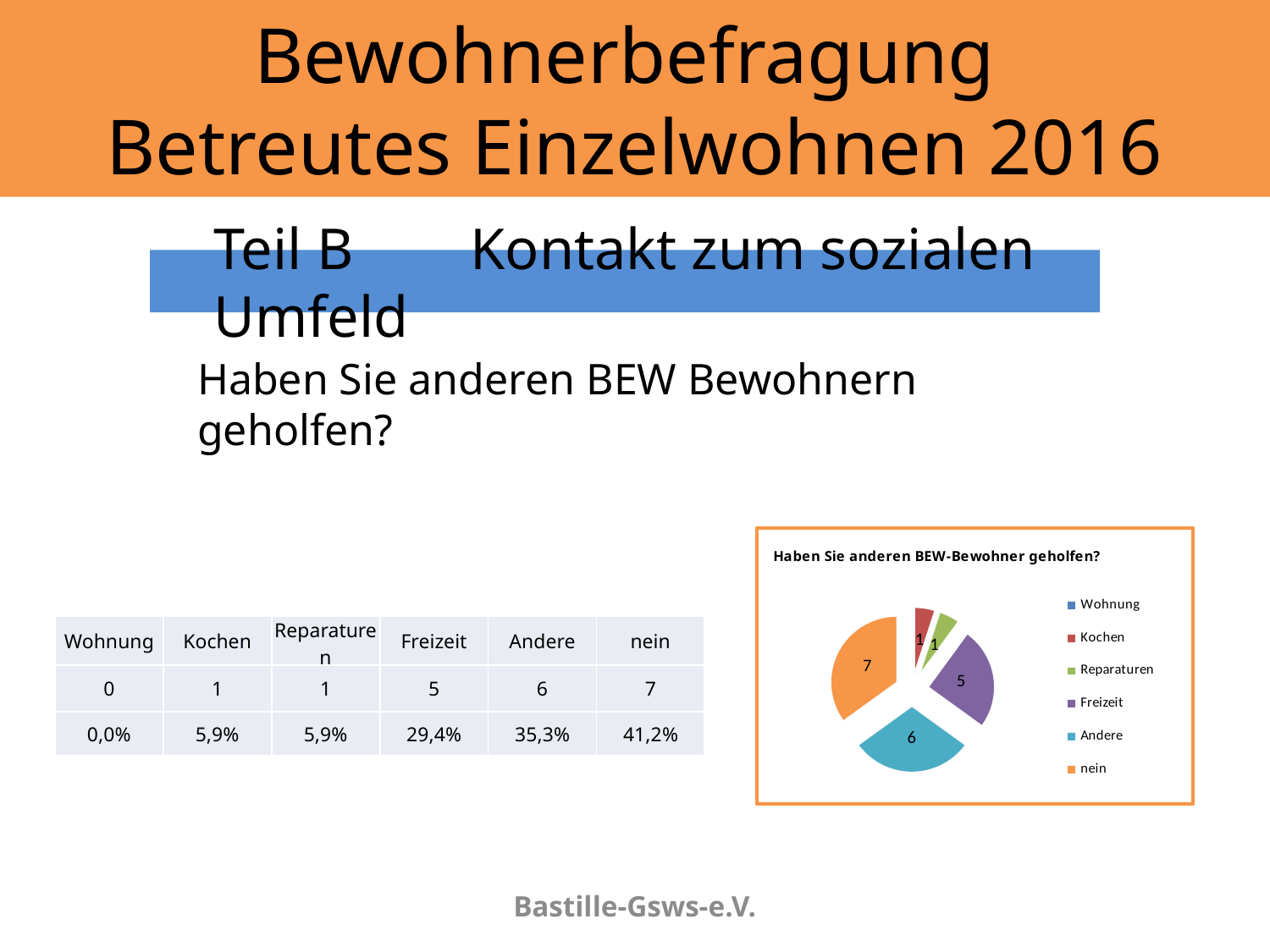
What type of chart is shown on the slide? pie chart How many entries does the chart's legend list? 6 What is the difference between the 'Andere' slice and the 'Reparaturen' slice in the pie chart? 5 What is the value shown for the 'Freizeit' slice in the pie chart? 5 Which is larger in the pie chart, the 'Andere' slice or the 'Freizeit' slice? Andere What is the value shown for the 'Andere' slice in the pie chart? 6 What is the difference between the 'nein' slice and the 'Freizeit' slice in the pie chart? 2 What is the value shown for the 'nein' slice in the pie chart? 7 Which category has the largest slice in the pie chart? nein What is the title of the chart on the slide? Haben Sie anderen BEW-Bewohner geholfen? Which legend entry in the pie chart is shown in orange? nein What is the value shown for the 'Kochen' slice in the pie chart? 1